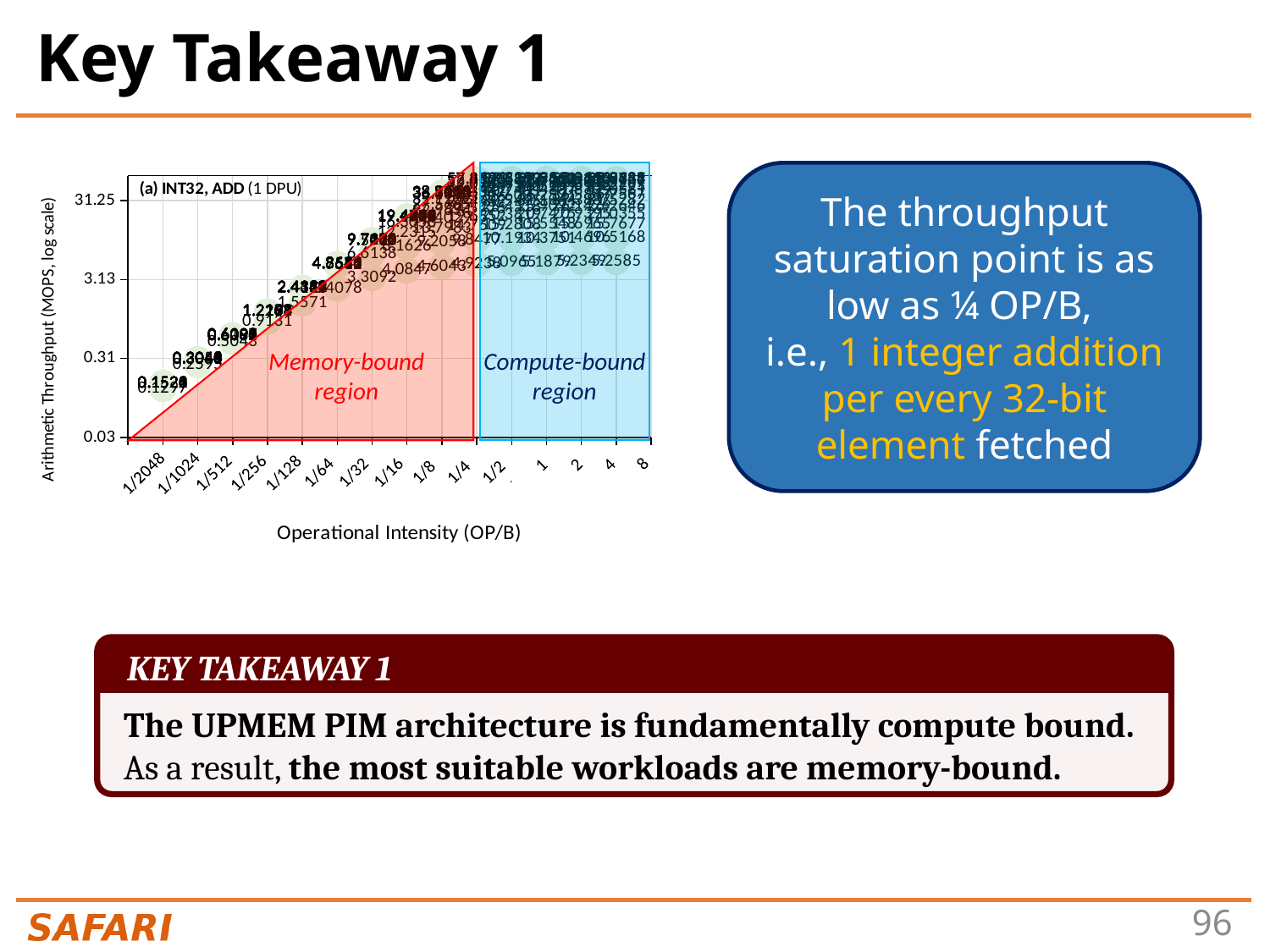
What is the title printed inside the chart? (a) INT32, ADD (1 DPU) Which has higher arithmetic throughput: operational intensity 1/2048 or operational intensity 8? 8 Is the arithmetic throughput at operational intensity 1/128 greater or less than 3.13 MOPS? less Is the arithmetic throughput at operational intensity 1/2048 greater or less than 0.31 MOPS? less Which has higher arithmetic throughput: operational intensity 1/1024 or operational intensity 1/64? 1/64 What kind of chart is shown on the slide? scatter chart How many operational intensity values are marked on the x axis of the chart? 15 Is the arithmetic throughput at operational intensity 8 greater or less than 3.13 MOPS? greater In the memory-bound region, does arithmetic throughput rise or fall as operational intensity increases? rise What is the label of the chart's x axis? Operational Intensity (OP/B)